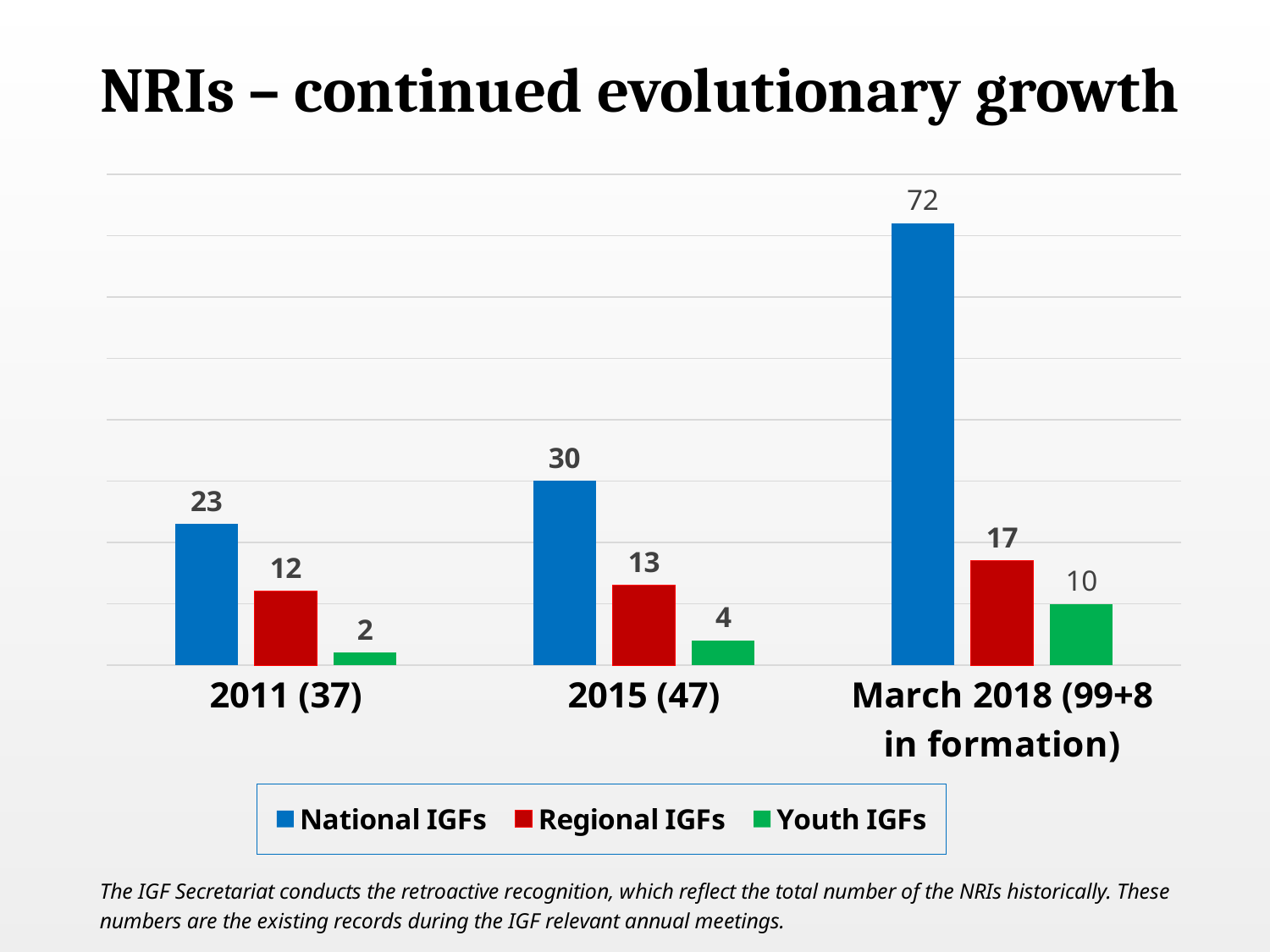
What is the difference between National IGFs in March 2018 (99+8 in formation) and National IGFs in 2015 (47)? 42 What colour represents Youth IGFs in the chart? Green Which is larger: Regional IGFs in 2015 (47) or Youth IGFs in March 2018 (99+8 in formation)? Regional IGFs in 2015 (47) What kind of chart is shown on the slide? Bar chart Which category has the highest value for National IGFs? March 2018 (99+8 in formation) What is the value for Regional IGFs in 2011 (37)? 12 Do the values for Regional IGFs rise or fall from 2011 (37) to March 2018 (99+8 in formation)? Rise What is the value for Youth IGFs in March 2018 (99+8 in formation)? 10 How many series does the legend list? 3 What is the value for National IGFs in 2015 (47)? 30 Which category has the lowest value for Youth IGFs? 2011 (37) How many categories are shown on the x axis? 3